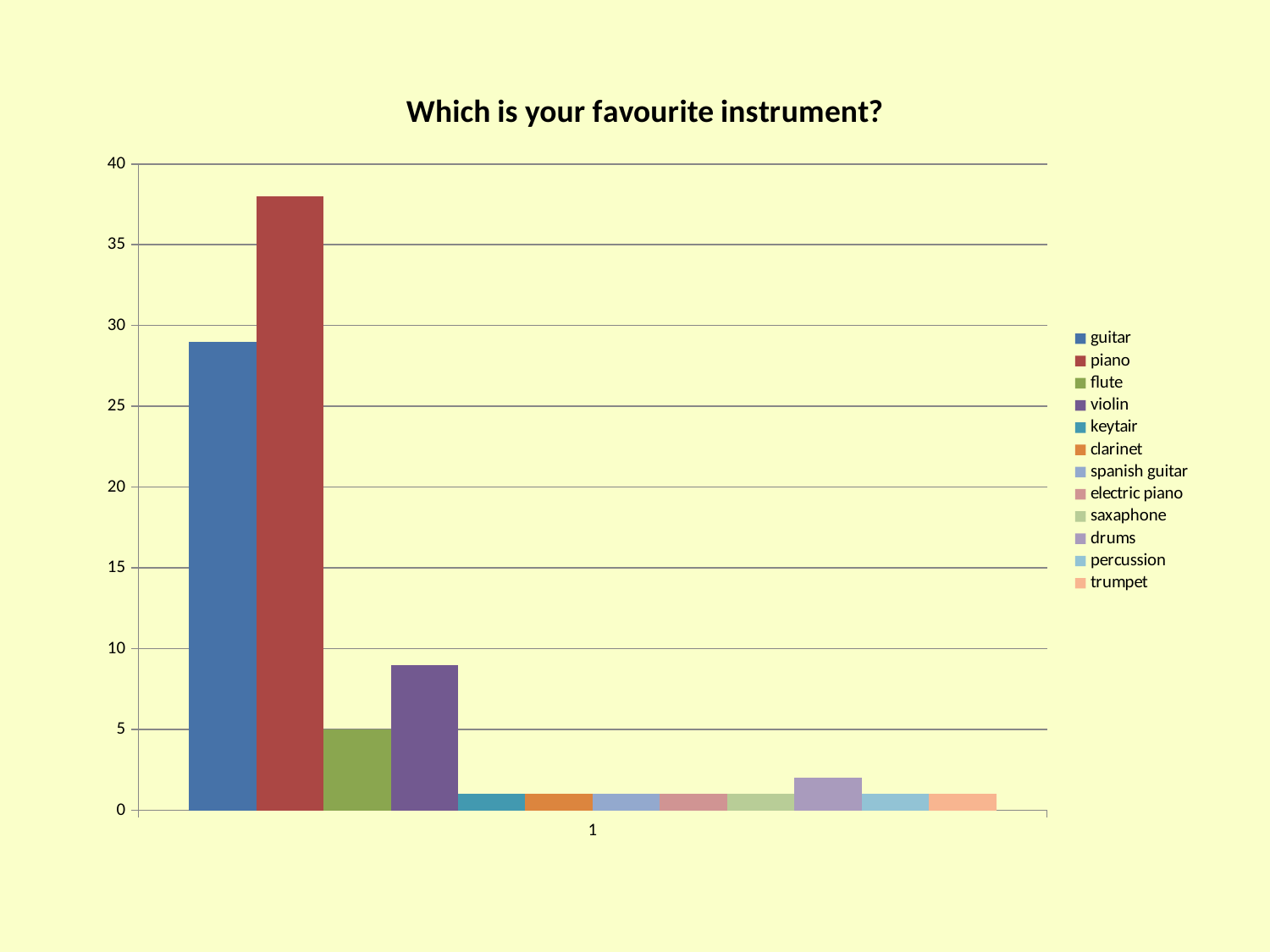
How many series does the legend list? 12 Which is larger, the value for guitar or the value for piano? piano Is the value for violin greater or less than 10? less Is the value for guitar greater or less than 25? greater What is the value for flute? 5 Which instrument has the highest bar? piano Which is larger, the value for violin or the value for flute? violin Is the value for piano greater or less than 35? greater What is the title of the chart? Which is your favourite instrument? What kind of chart is shown on the slide? bar chart What colour is the bar for piano? red